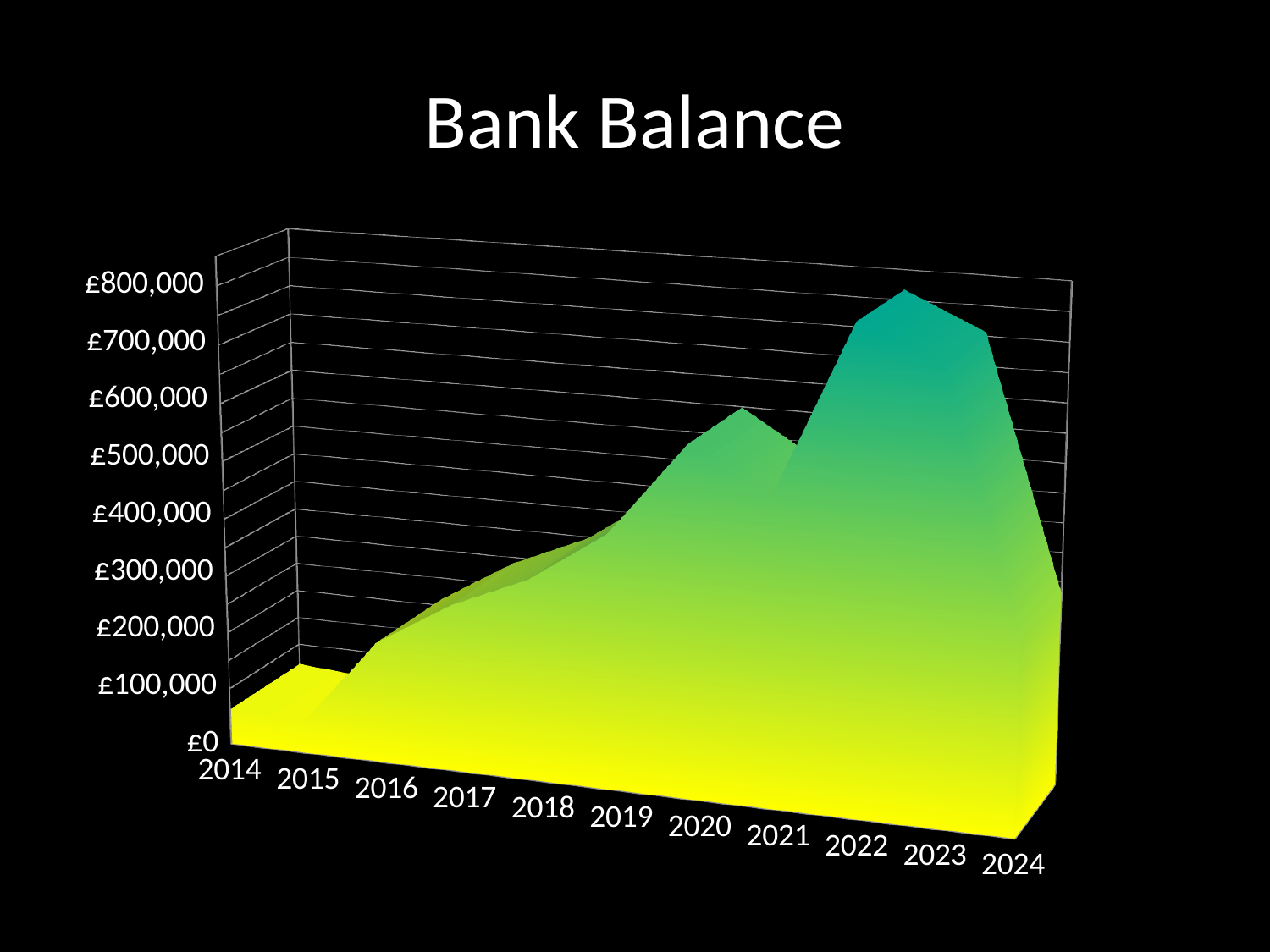
Does the bank balance rise or fall from 2022 to 2024? Fall How many years are shown on the x axis of the chart? 11 What is the title of the chart? Bank Balance Is the bank balance for 2016 greater or less than £400,000? less Is the bank balance for 2022 greater or less than £600,000? greater Which is larger, the bank balance in 2016 or in 2020? 2020 Is the bank balance for 2020 greater or less than £400,000? greater Which year has the highest bank balance? 2022 Which is larger, the bank balance in 2022 or in 2024? 2022 What is the highest value labelled on the vertical axis? £800,000 What kind of chart is shown on the slide? Area chart